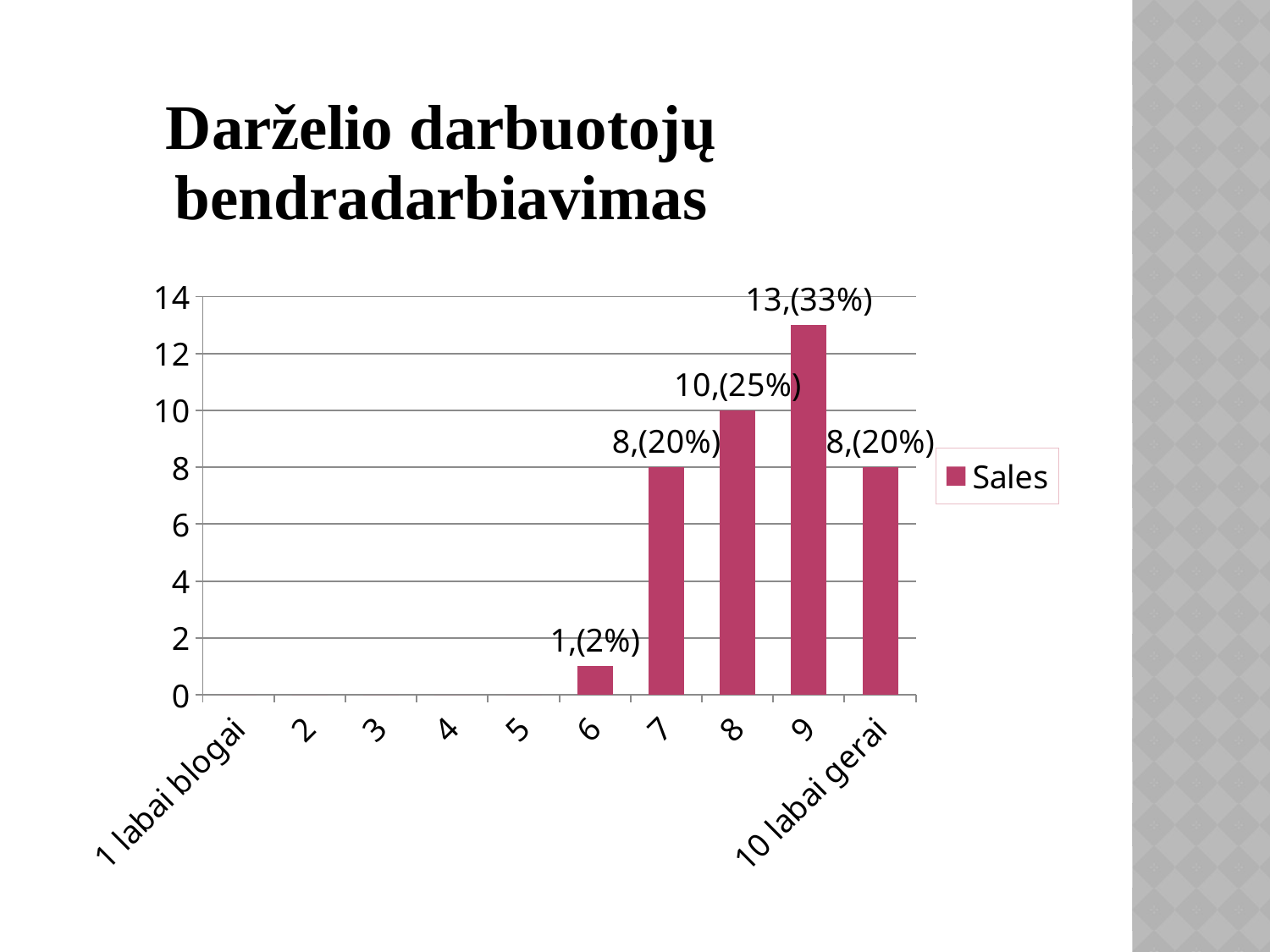
Which category has the tallest bar? 9 Among the categories with visible bars, which has the lowest value? 6 Is the value for category 9 greater or less than 12? greater What is the difference between the count for category 9 and the count for category 8? 3 What is the data label on the bar for category 6? 1,(2%) What is the data label on the bar for '10 labai gerai'? 8,(20%) How many categories are shown on the x axis? 10 What is the data label on the bar for category 8? 10,(25%) How many series does the legend list? 1 What is the data label on the bar for category 9? 13,(33%) What kind of chart is shown on the slide? bar chart Which is larger, the value for category 7 or the value for category 8? 8